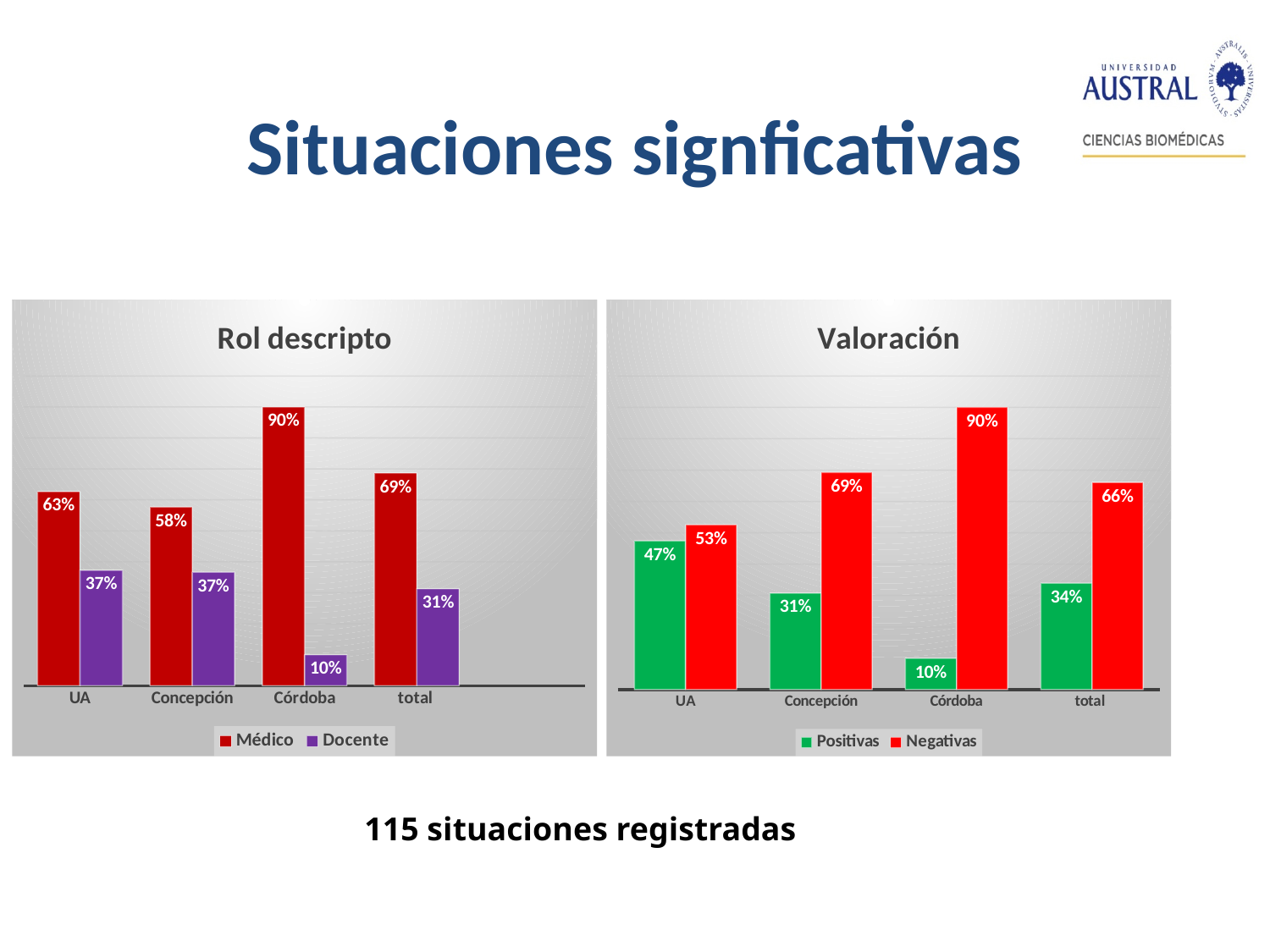
In the 'Valoración' chart, which is larger for total: Positivas or Negativas? Negativas How many categories are shown on the x axis of the 'Valoración' chart? 4 In the 'Valoración' chart, what is the difference between Negativas and Positivas for Córdoba? 80% In the 'Valoración' chart, which category has the highest Negativas value? Córdoba In the 'Valoración' chart, what is the value for Positivas in UA? 47% What type of chart is the 'Rol descripto' chart? Bar chart In the 'Rol descripto' chart, what is the value for Médico in Córdoba? 90% In the 'Rol descripto' chart, which category has the lowest Docente value? Córdoba In the 'Rol descripto' chart, how many series does the legend list? 2 In the 'Rol descripto' chart, what is the difference between the Médico and Docente values for UA? 26% In the 'Valoración' chart, what is the value for Negativas in Concepción? 69% In the 'Rol descripto' chart, what is the value for Docente in total? 31%